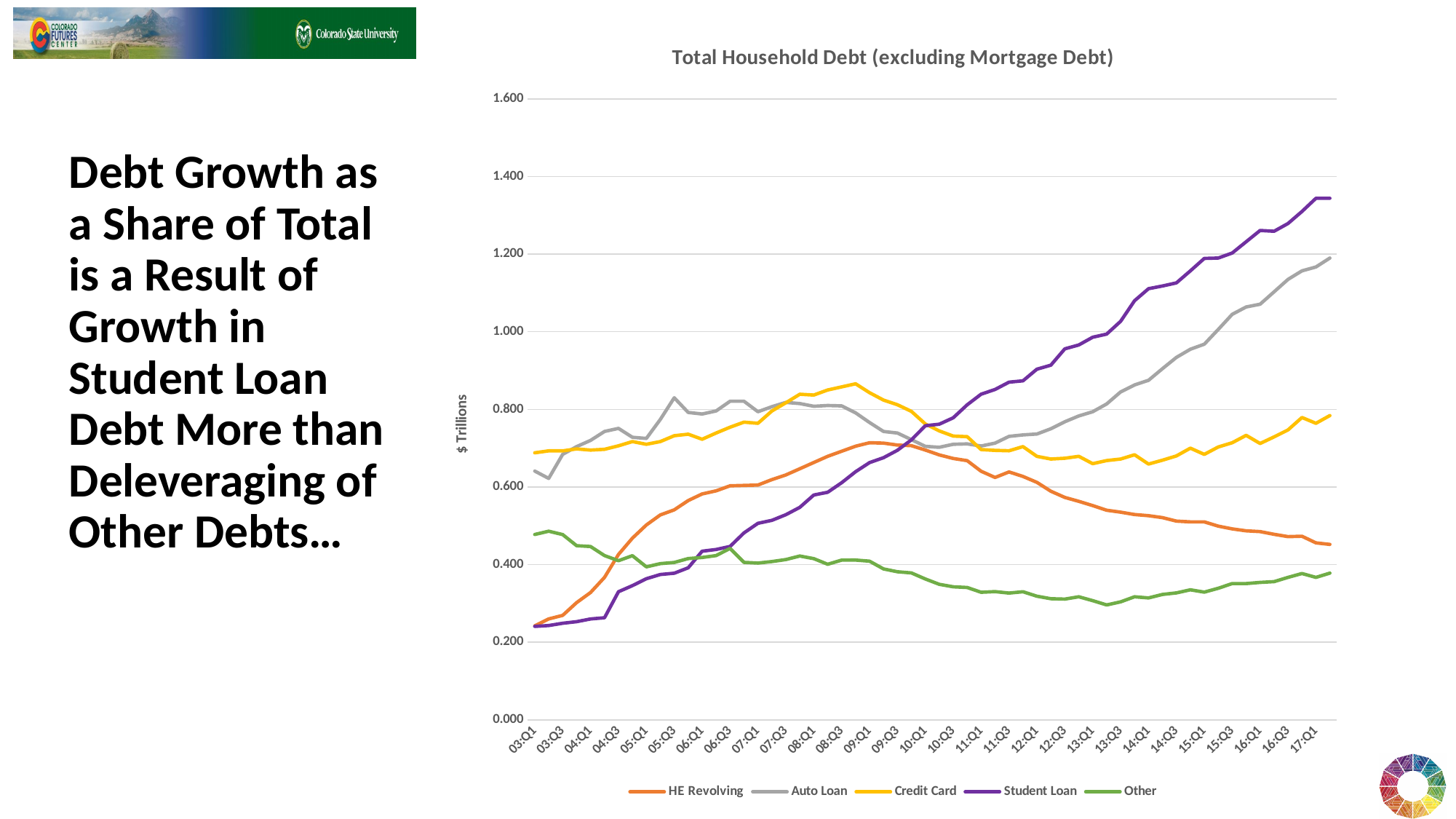
Is the value for Auto Loan at 17:Q1 greater or less than 1.000? greater Is the value for Other at 17:Q1 greater or less than 0.400? less What is the label on the vertical axis? $ Trillions Which series has the highest value at 17:Q1? Student Loan What kind of chart is shown on the slide? line chart How many series does the legend list? 5 Is the value for Student Loan at 03:Q1 greater or less than 0.400? less What is the title of the chart? Total Household Debt (excluding Mortgage Debt) Which series has the lowest value at 17:Q1? Other Does the Student Loan series rise or fall from 03:Q1 to 17:Q1? rise At 03:Q1, which is larger: Credit Card or Student Loan? Credit Card